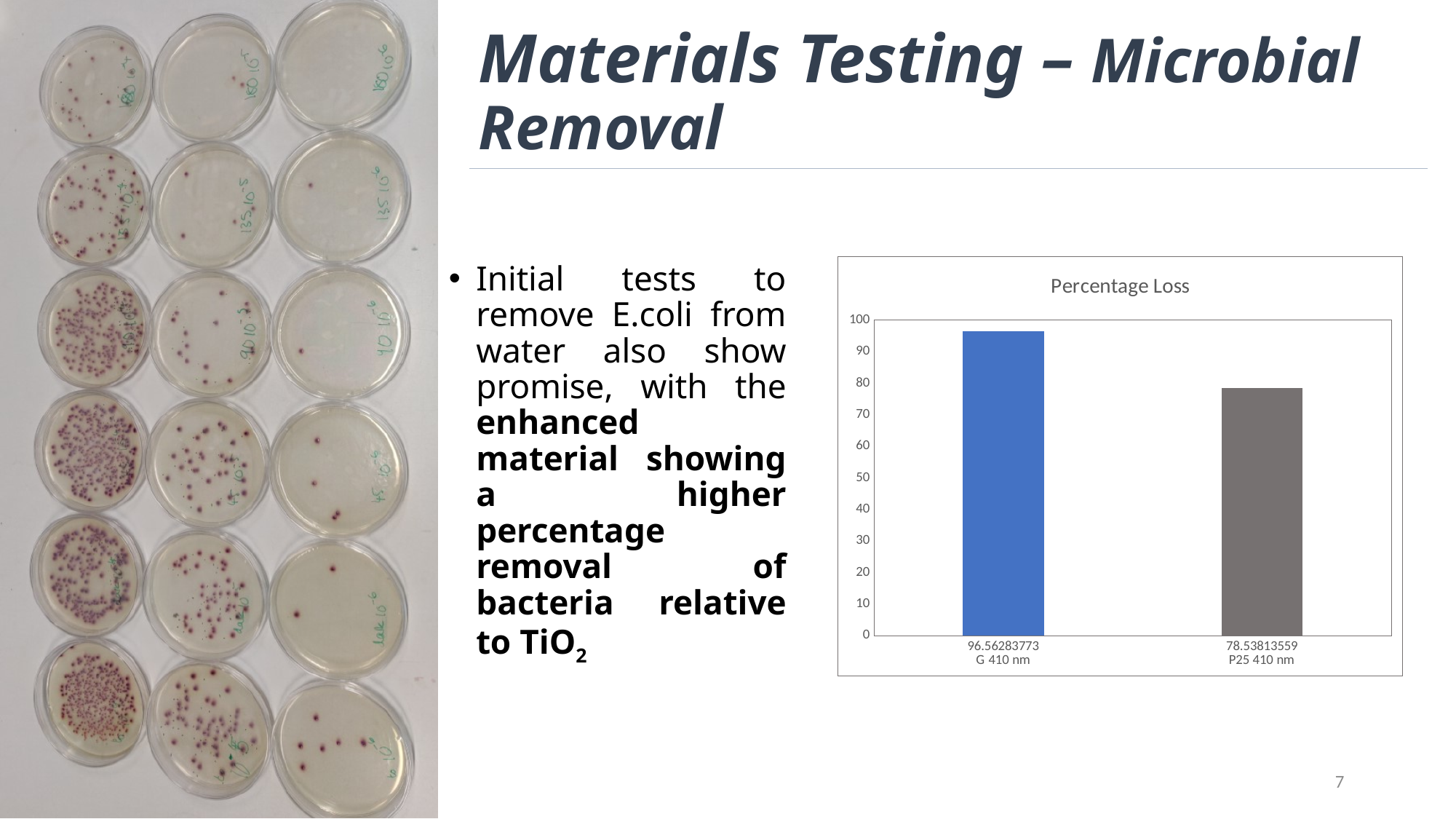
Which category has the highest percentage loss? G 410 nm Which has a larger percentage loss, G 410 nm or P25 410 nm? G 410 nm What is the difference between the percentage loss for G 410 nm and P25 410 nm? 18.02470214 Is the value for P25 410 nm greater or less than 80? less What is the percentage loss value shown for G 410 nm? 96.56283773 What colour is the bar for G 410 nm? blue What is the percentage loss value shown for P25 410 nm? 78.53813559 What type of chart is shown on the slide? bar chart How many bars are plotted in the Percentage Loss chart? 2 Which category has the lowest percentage loss? P25 410 nm What is the title of the chart? Percentage Loss Is the value for G 410 nm greater or less than 90? greater